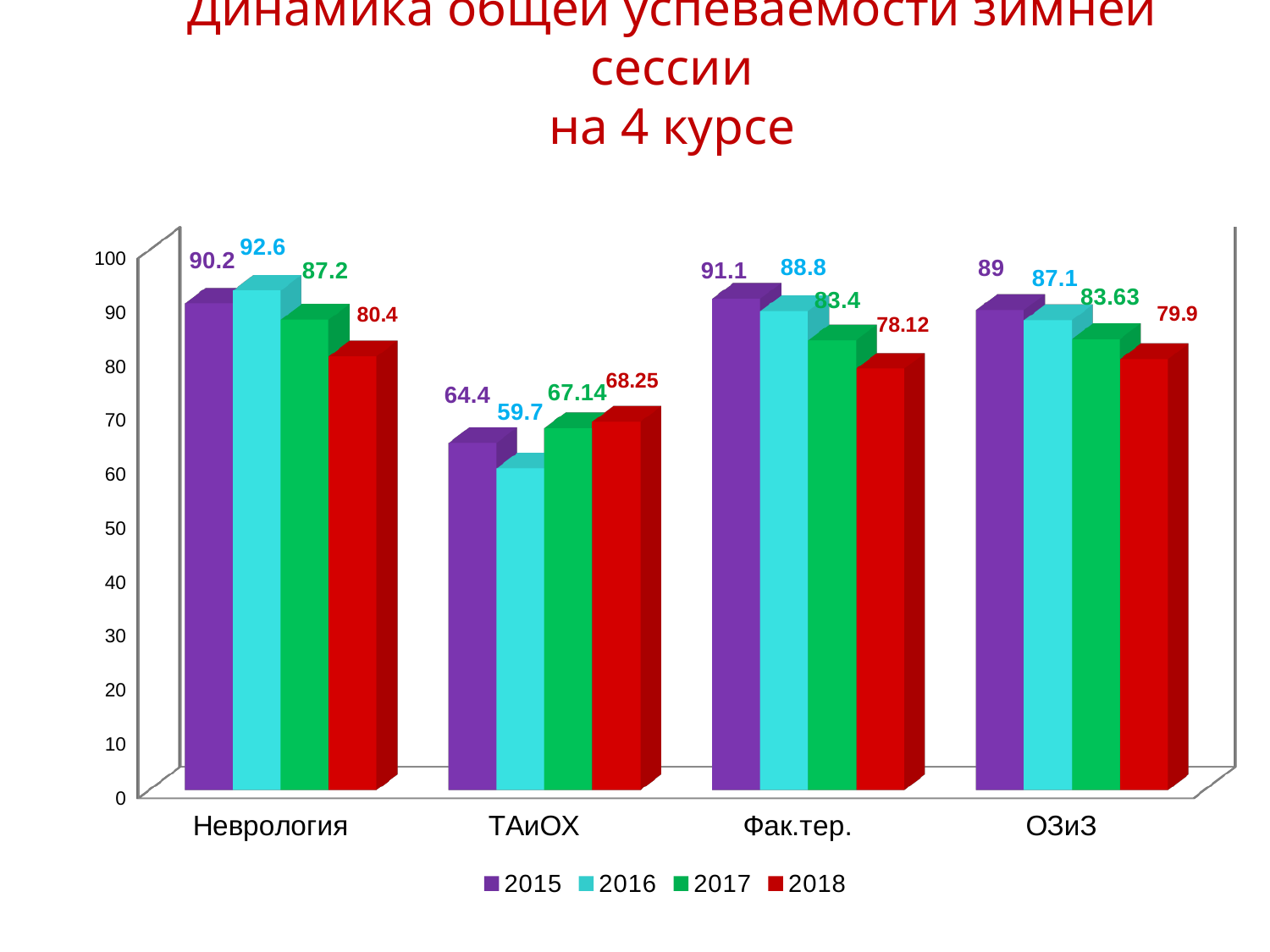
What kind of chart is shown on the slide? Bar chart How many series does the legend list? 4 How many categories are shown on the x axis? 4 Which colour represents the 2018 series in the legend? Red What is the value for Фак.тер. in 2017? 83.4 Which is larger for ОЗиЗ: the 2016 value or the 2017 value? 2016 What is the difference between the 2015 and 2018 values for Неврология? 9.8 What is the value for Неврология in 2016? 92.6 What is the value for ТАиОХ in 2018? 68.25 Which category has the lowest value in the 2016 series? ТАиОХ What is the value for ОЗиЗ in 2015? 89 Which category has the highest value in the 2015 series? Фак.тер.